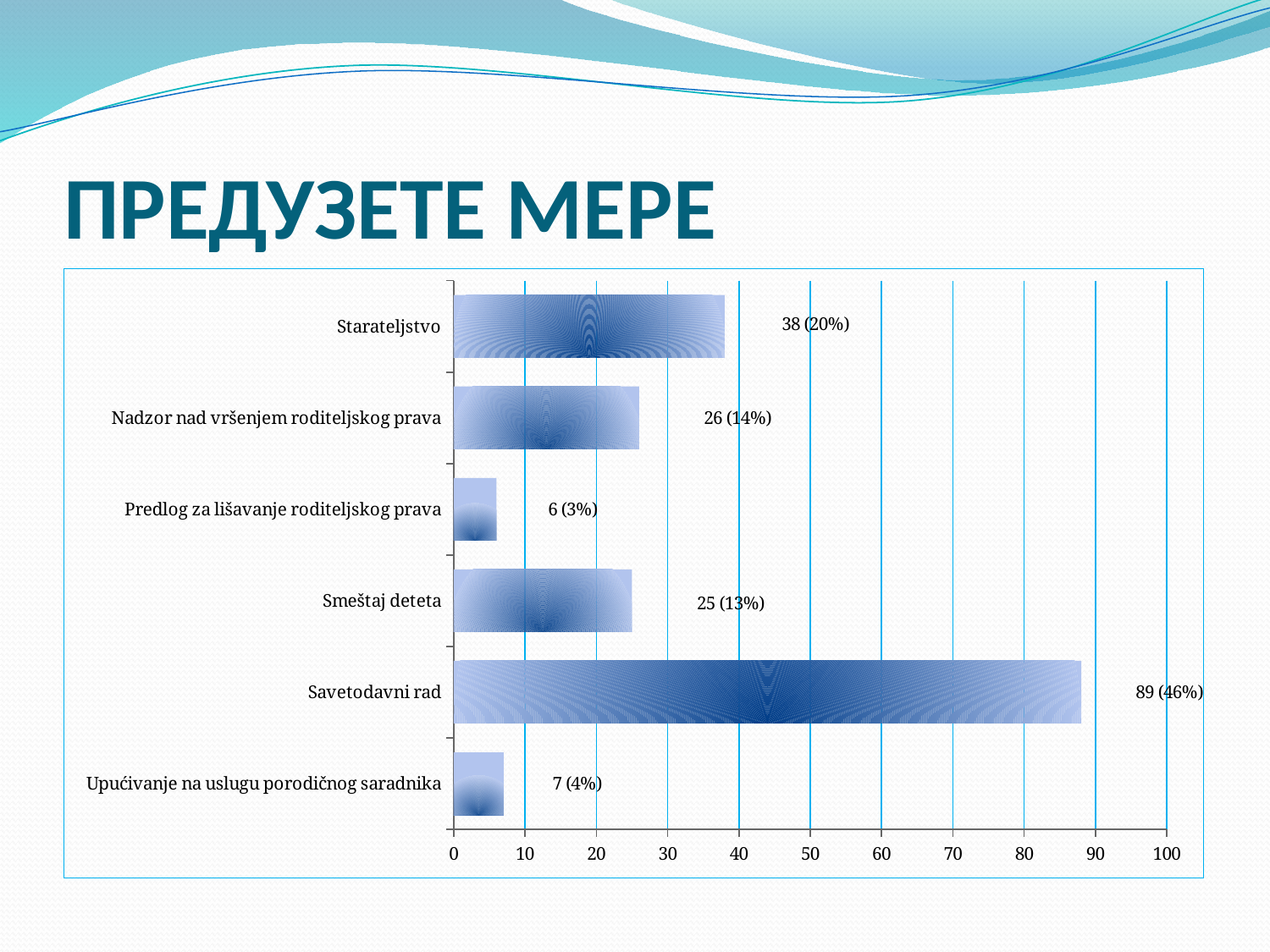
What value is shown for Savetodavni rad? 89 (46%) What is the difference between the counts for Savetodavni rad and Starateljstvo? 51 Which is larger, the value for Starateljstvo or for Nadzor nad vršenjem roditeljskog prava? Starateljstvo How many categories are shown in the chart? 6 What is the title of the slide? ПРЕДУЗЕТЕ МЕРЕ What value is shown for Smeštaj deteta? 25 (13%) Which category has the highest value? Savetodavni rad What percentage is shown for Upućivanje na uslugu porodičnog saradnika? 4% What value is shown for Starateljstvo? 38 (20%) Is the value for Savetodavni rad greater or less than 80? greater What kind of chart is shown on the slide? bar chart Which category has the lowest value? Predlog za lišavanje roditeljskog prava